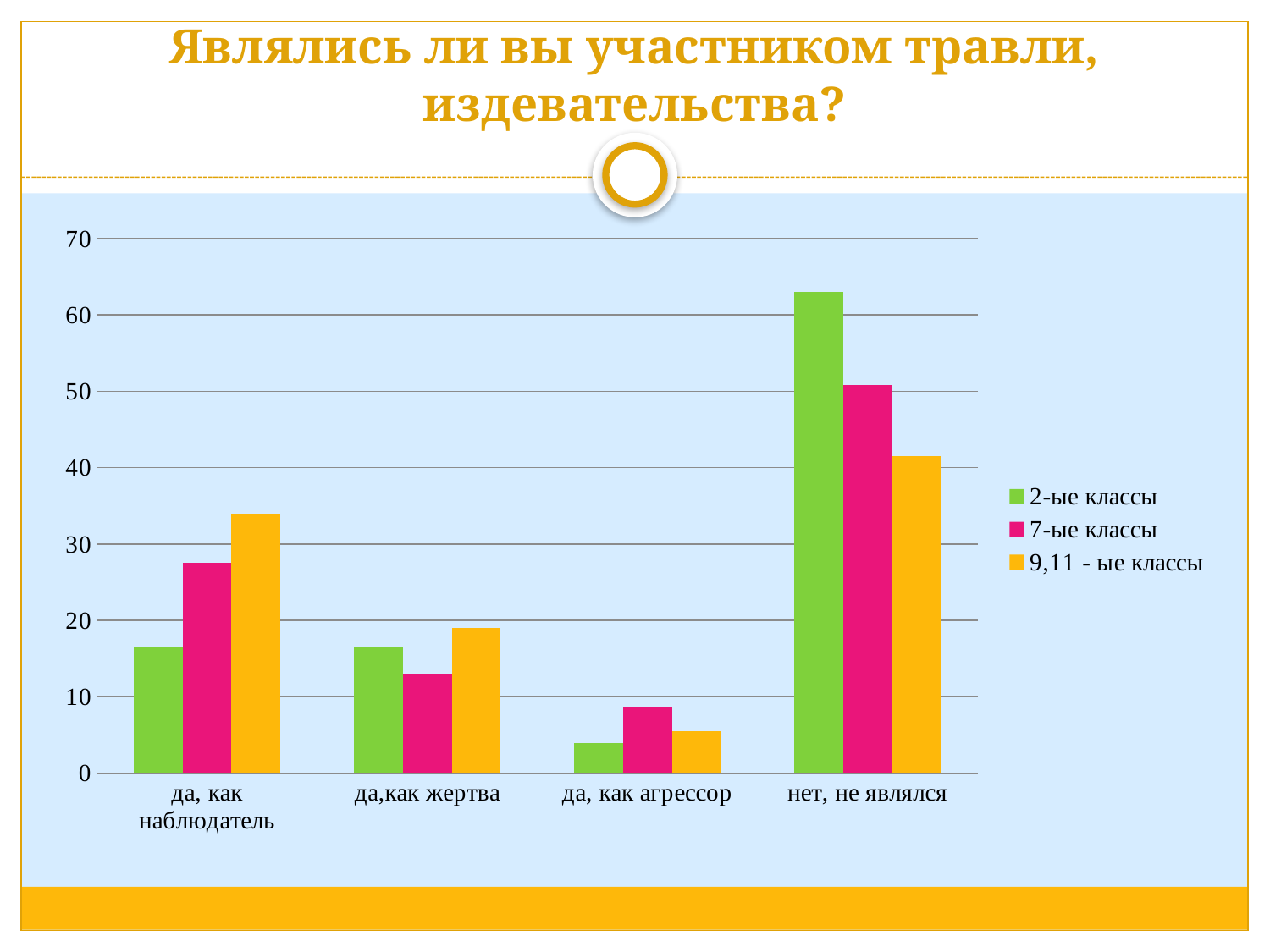
In the category да, как наблюдатель, which series has the larger value: 2-ые классы or 9,11 - ые классы? 9,11 - ые классы What is the title of the slide above the chart? Являлись ли вы участником травли, издевательства? Which category has the highest value for the 2-ые классы series? нет, не являлся Is the value for 2-ые классы in the category нет, не являлся greater or less than 60? greater How many series does the legend list? 3 In the category нет, не являлся, which series has the larger value: 7-ые классы or 9,11 - ые классы? 7-ые классы Which category has the lowest value for the 9,11 - ые классы series? да, как агрессор Is the value for 9,11 - ые классы in the category да, как наблюдатель greater or less than 30? greater How many categories are shown on the x axis? 4 Is the value for 7-ые классы in the category да, как агрессор greater or less than 10? less What kind of chart is shown on the slide? bar chart Which series is shown in yellow in the legend? 9,11 - ые классы